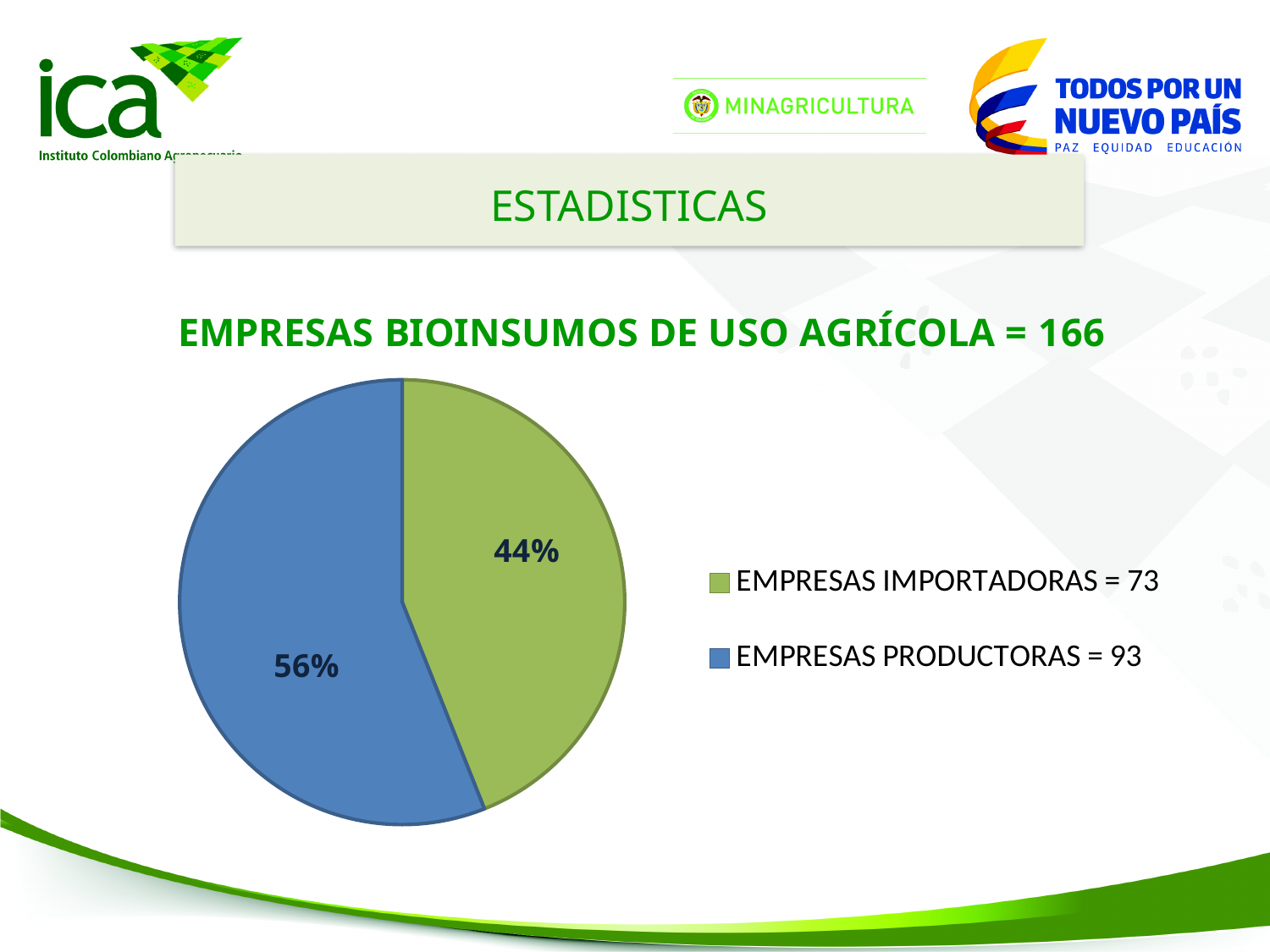
What kind of chart is shown on the slide? pie chart Which category has the larger share of the pie? EMPRESAS PRODUCTORAS What colour is the slice for EMPRESAS PRODUCTORAS? blue What total number of companies is stated in the chart heading? 166 What is the difference between the number of EMPRESAS PRODUCTORAS and EMPRESAS IMPORTADORAS? 20 How many companies are listed in the legend for EMPRESAS PRODUCTORAS? 93 What percentage share of the pie is labelled for EMPRESAS IMPORTADORAS? 44% What is the difference in percentage points between the EMPRESAS PRODUCTORAS and EMPRESAS IMPORTADORAS slices? 12% How many companies are listed in the legend for EMPRESAS IMPORTADORAS? 73 Which category has the smaller share of the pie? EMPRESAS IMPORTADORAS What percentage share of the pie is labelled for EMPRESAS PRODUCTORAS? 56% How many slices does the pie chart have? 2